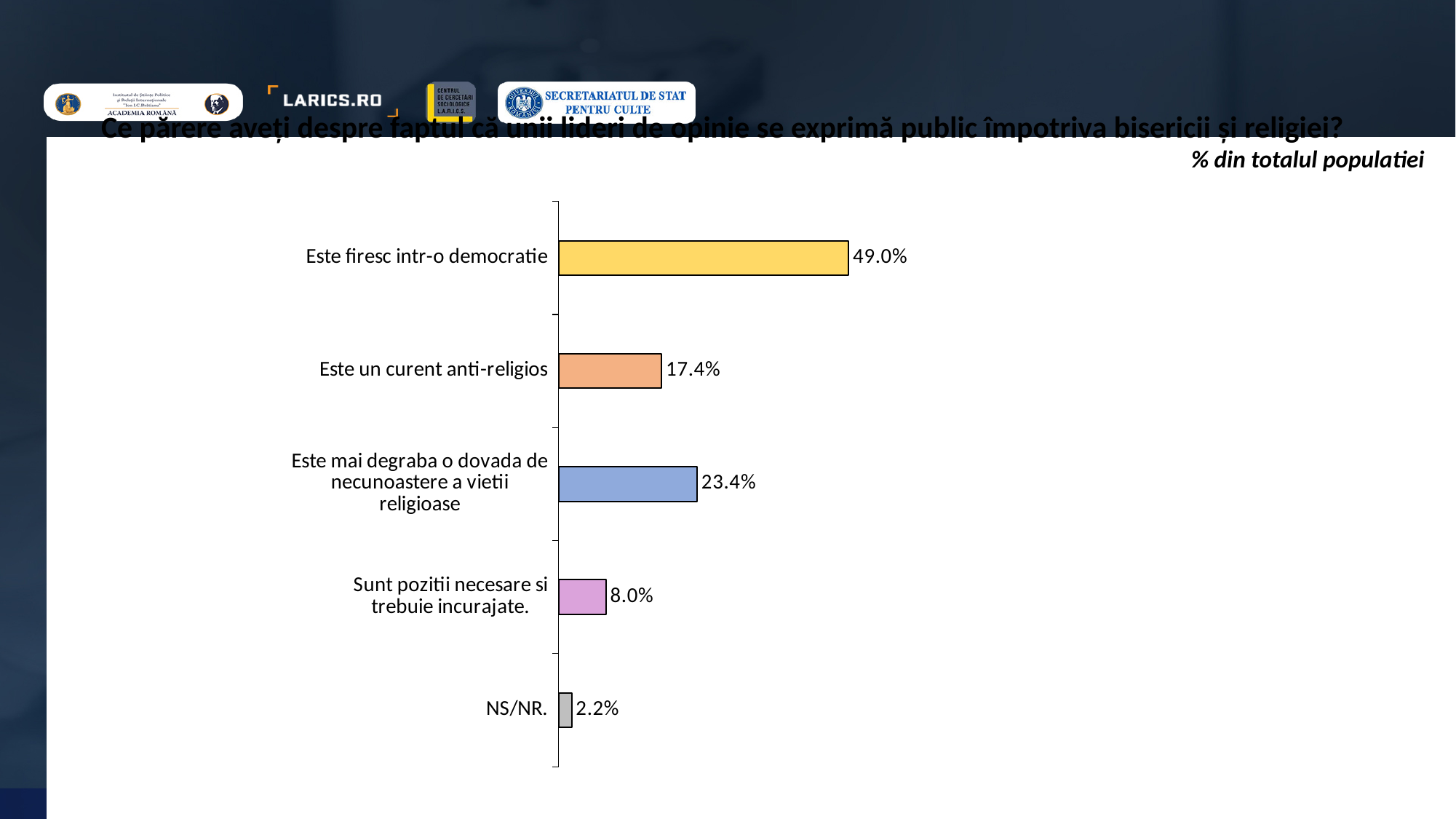
What kind of chart is shown on the slide? Bar chart How many categories are shown in the chart? 5 What is the difference between "Este firesc intr-o democratie" and "Este un curent anti-religios"? 31.6% Which category has the lowest value? NS/NR. What is the value for "Este mai degraba o dovada de necunoastere a vietii religioase"? 23.4% What is the value for "Este un curent anti-religios"? 17.4% Which category has the highest value? Este firesc intr-o democratie What is the value for "Sunt pozitii necesare si trebuie incurajate."? 8.0% What is the value for "NS/NR."? 2.2% What unit note is shown at the top right of the chart? % din totalul populatiei What is the value for "Este firesc intr-o democratie"? 49.0% Which is larger: "Este un curent anti-religios" or "Este mai degraba o dovada de necunoastere a vietii religioase"? Este mai degraba o dovada de necunoastere a vietii religioase